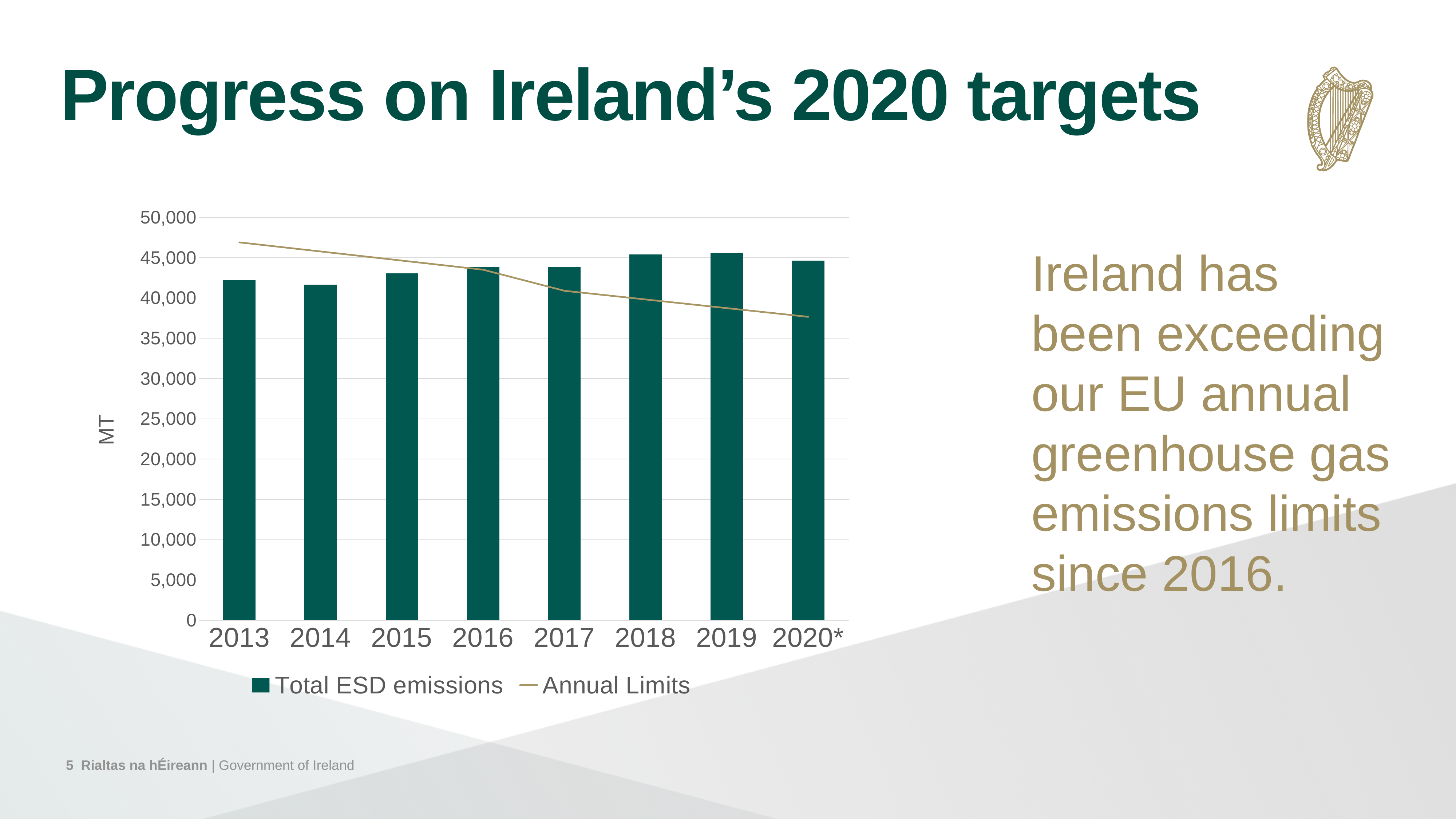
Which year has the larger Total ESD emissions, 2014 or 2018? 2018 Is the Total ESD emissions value for 2013 greater or less than 40,000? greater What is the label on the vertical axis of the chart? MT Is the Annual Limits value for 2020* greater or less than 40,000? less Is the Annual Limits value for 2013 greater or less than 45,000? greater What kind of chart is shown on the slide? bar and line chart What are the two entries in the chart legend? Total ESD emissions and Annual Limits How many years are shown on the x axis of the chart? 8 How many series does the chart legend list? 2 Do the Annual Limits values rise or fall from 2013 to 2020*? fall